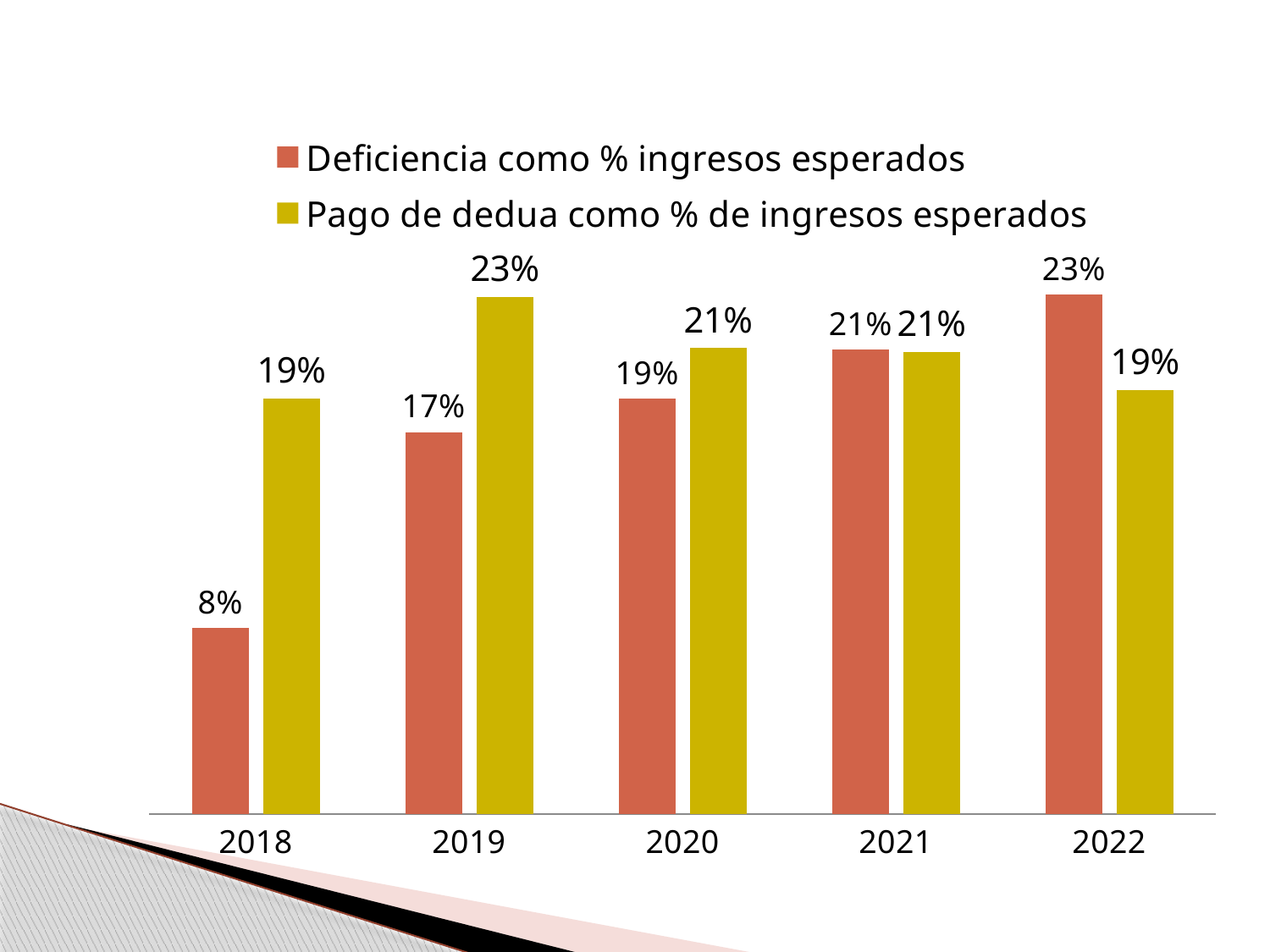
What is the value of 'Pago de dedua como % de ingresos esperados' for 2022? 19% What kind of chart is shown on the slide? Bar chart How many series does the legend list? 2 What is the value of 'Deficiencia como % ingresos esperados' for 2022? 23% How many years are shown on the x axis? 5 Does 'Deficiencia como % ingresos esperados' rise or fall from 2018 to 2022? Rise Which is larger in 2022: 'Deficiencia como % ingresos esperados' or 'Pago de dedua como % de ingresos esperados'? Deficiencia como % ingresos esperados What is the value of 'Deficiencia como % ingresos esperados' for 2018? 8% In which year is 'Pago de dedua como % de ingresos esperados' highest? 2019 What is the difference between 'Pago de dedua como % de ingresos esperados' and 'Deficiencia como % ingresos esperados' in 2018? 11% What is the value of 'Pago de dedua como % de ingresos esperados' for 2019? 23% In which year is 'Deficiencia como % ingresos esperados' lowest? 2018